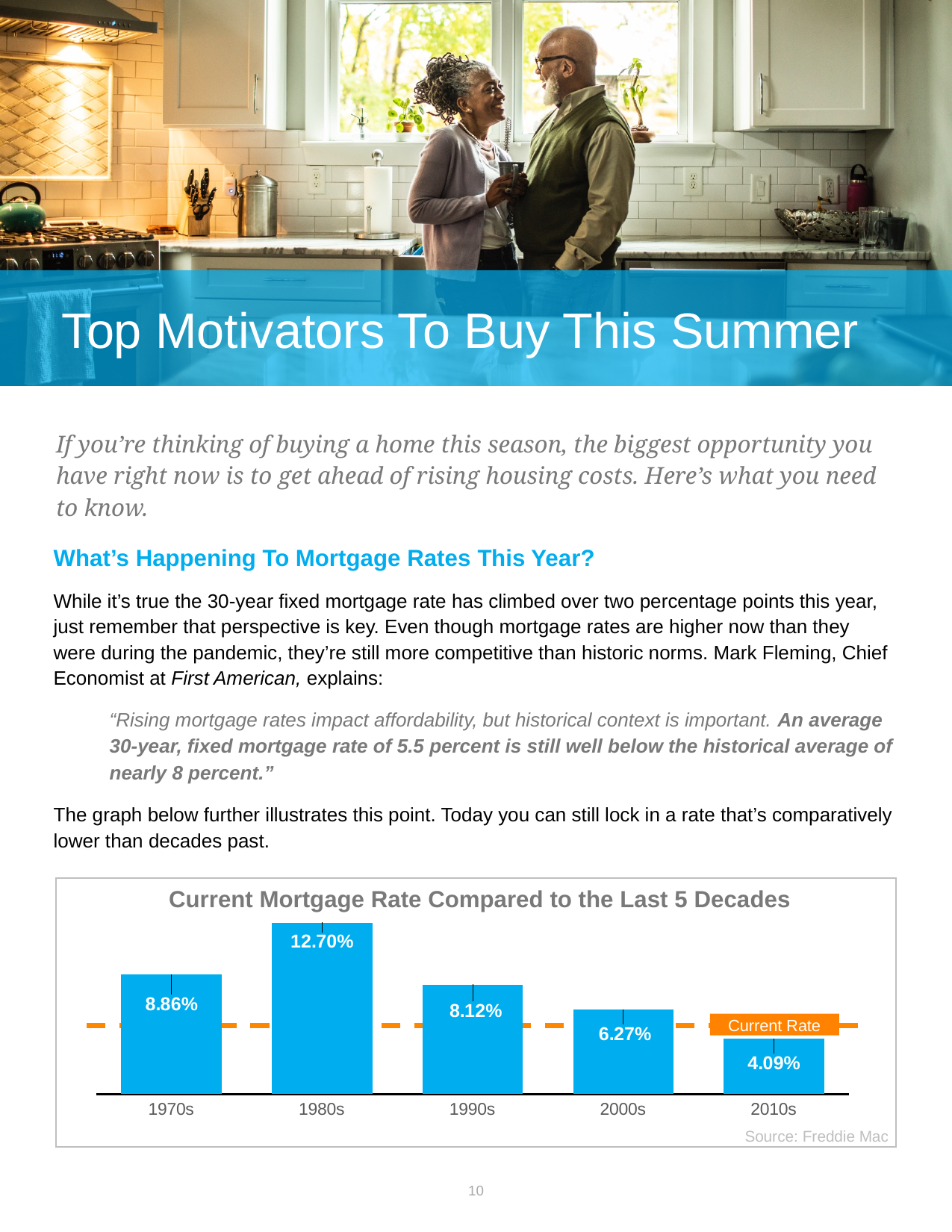
Which decade has the highest mortgage rate in the chart? 1980s Which decade has the lowest mortgage rate in the chart? 2010s What is the mortgage rate shown for the 1980s? 12.70% How many decades are plotted in the chart? 5 What kind of chart is shown on the slide? Bar chart What is the mortgage rate shown for the 2010s? 4.09% Which is larger, the rate for the 1970s or the rate for the 1990s? 1970s Do the mortgage rates rise or fall from the 1980s to the 2010s? Fall What is the mortgage rate shown for the 1970s? 8.86% What is the difference between the 1980s rate and the 2010s rate? 8.61% What is the difference between the 1990s rate and the 2000s rate? 1.85% What is the title of the chart? Current Mortgage Rate Compared to the Last 5 Decades